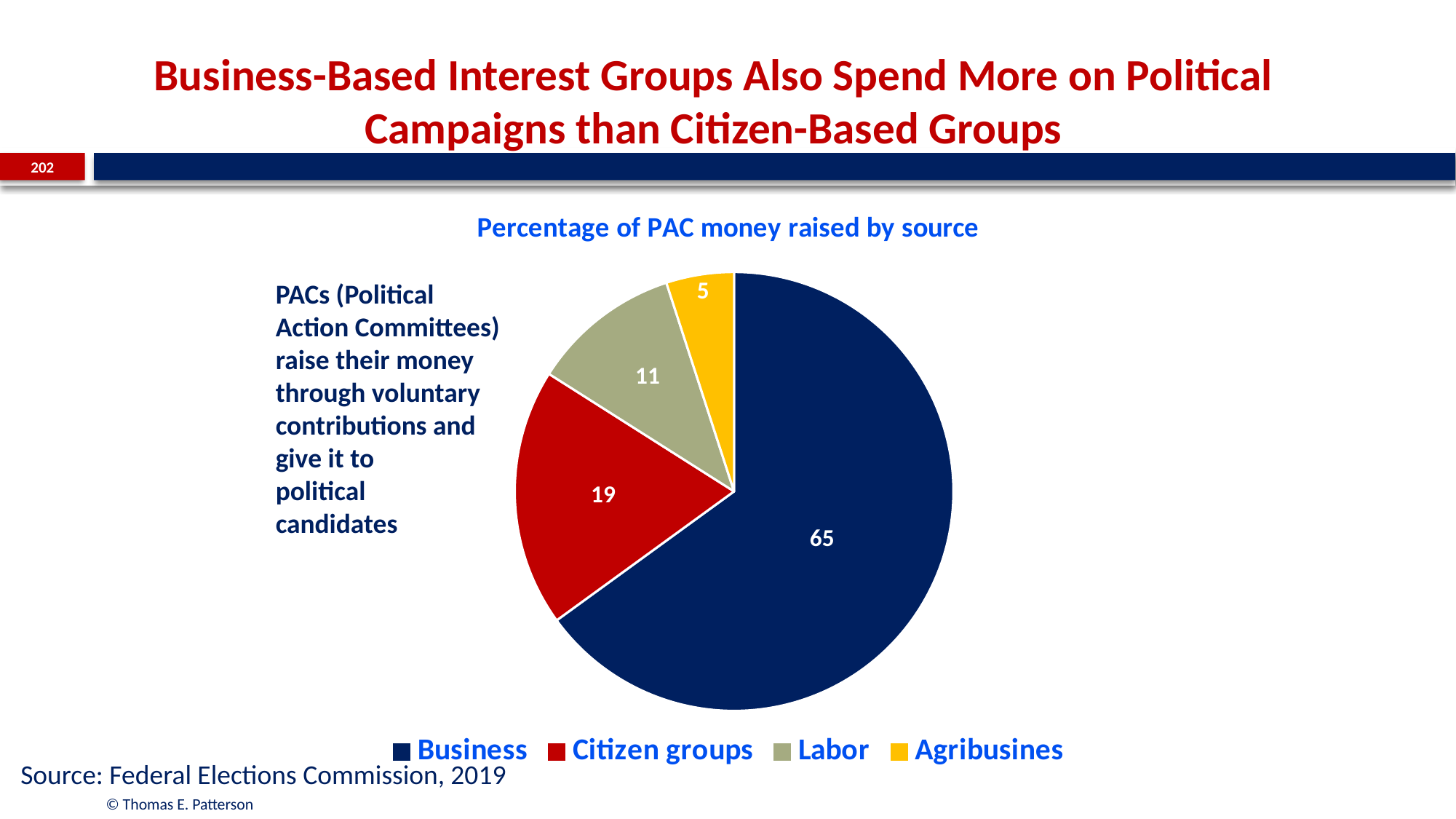
What colour is the Citizen groups slice in the pie chart? red What is the value for Labor in the pie chart? 11 What is the title of the pie chart? Percentage of PAC money raised by source What kind of chart is shown on the slide? pie chart What is the difference between the values for Business and Citizen groups? 46 Which source has the largest share of PAC money raised? Business What is the value for Agribusines in the pie chart? 5 What is the value for Citizen groups in the pie chart? 19 What is the value for Business in the pie chart? 65 Which is larger, the value for Labor or the value for Agribusines? Labor Which source has the smallest share of PAC money raised? Agribusines How many slices does the pie chart have? 4